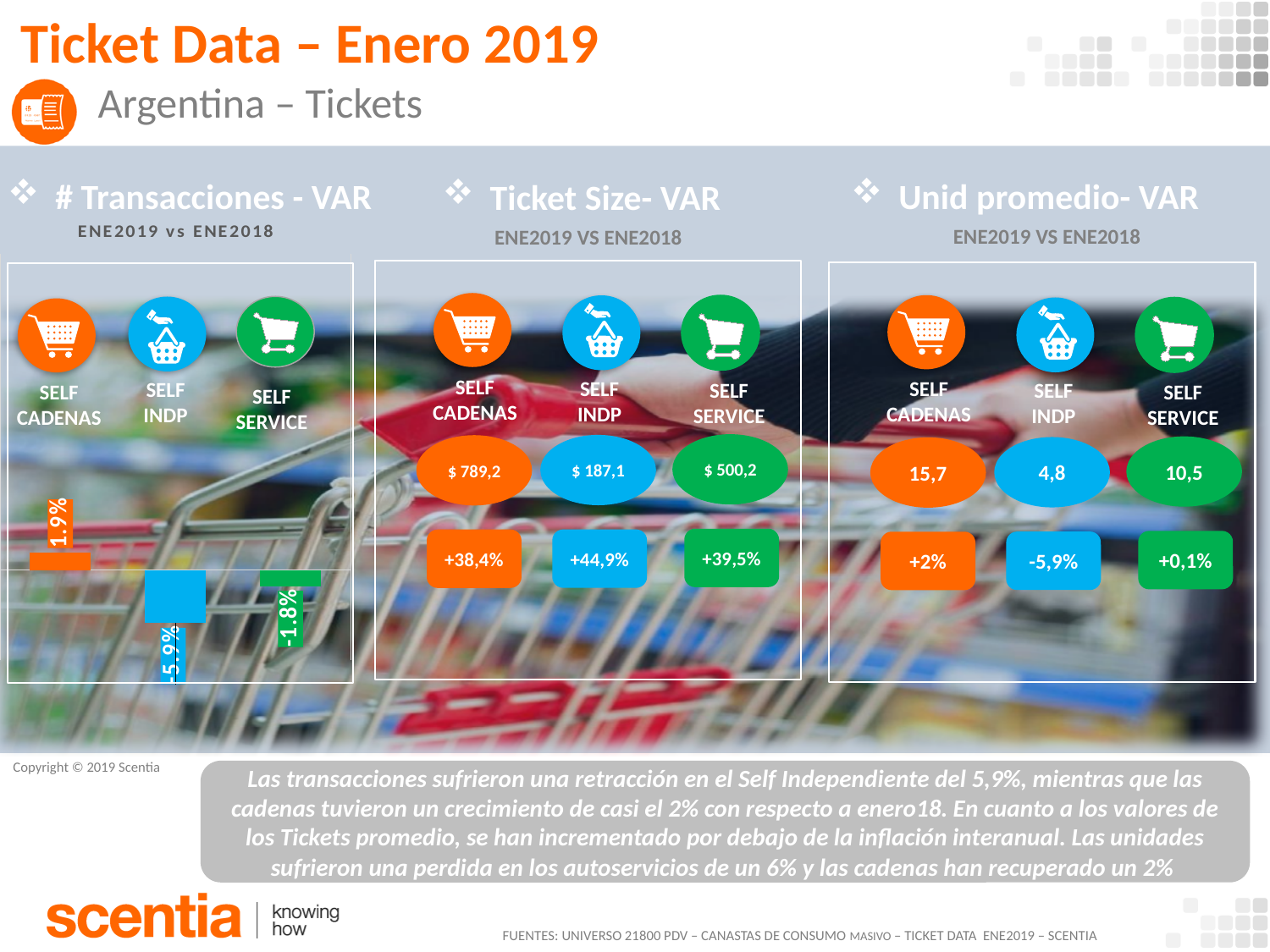
In the '# Transacciones - VAR' chart, which category has the lowest value? SELF INDP What comparison period is shown under the '# Transacciones - VAR' chart title? ENE2019 vs ENE2018 What type of chart is the '# Transacciones - VAR' chart? Bar chart In the '# Transacciones - VAR' chart, what is the difference between the SELF CADENAS value and the SELF SERVICE value? 3.7 percentage points In the '# Transacciones - VAR' chart, which is larger, the value for SELF INDP or SELF SERVICE? SELF SERVICE In the '# Transacciones - VAR' chart, what is the value for SELF CADENAS? 1.9% How many categories are shown in the '# Transacciones - VAR' chart? 3 In the '# Transacciones - VAR' chart, how many categories have a negative value? 2 In the '# Transacciones - VAR' chart, what is the difference between the SELF CADENAS value and the SELF INDP value? 7.8 percentage points In the '# Transacciones - VAR' chart, which category has the highest value? SELF CADENAS In the '# Transacciones - VAR' chart, what is the value for SELF INDP? -5.9% In the '# Transacciones - VAR' chart, what is the value for SELF SERVICE? -1.8%